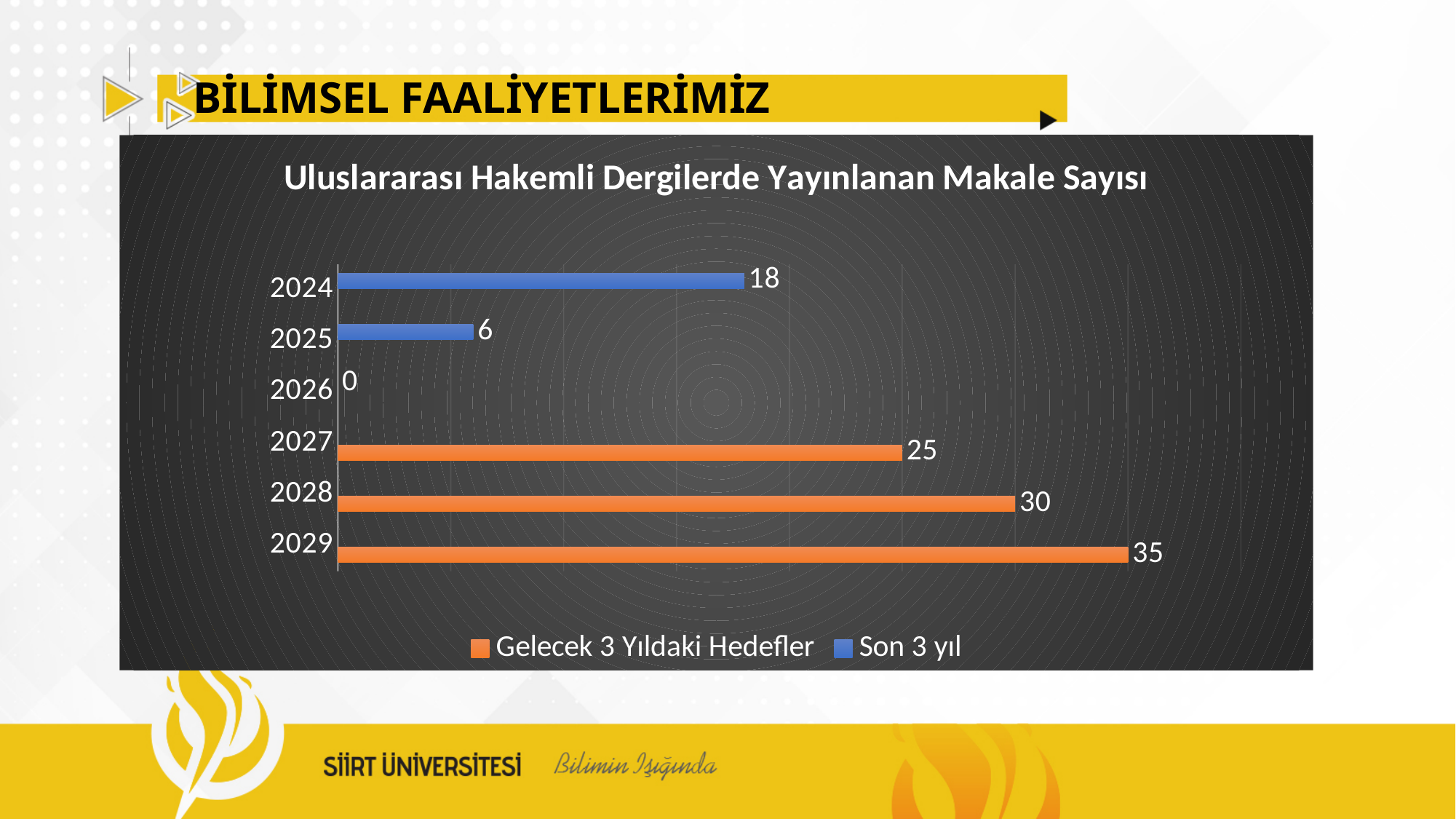
What is the title of the chart? Uluslararası Hakemli Dergilerde Yayınlanan Makale Sayısı Which is larger, the value for 2024 or the value for 2027? 2027 What is the value for 2024? 18 What is the value for 2025? 6 Which year has the highest value? 2029 Which year has the lowest value? 2026 How many years are shown on the chart? 6 What kind of chart is shown? bar chart How many series does the legend list? 2 What is the difference between the values for 2029 and 2027? 10 What is the value for 2029? 35 What is the value for 2026? 0